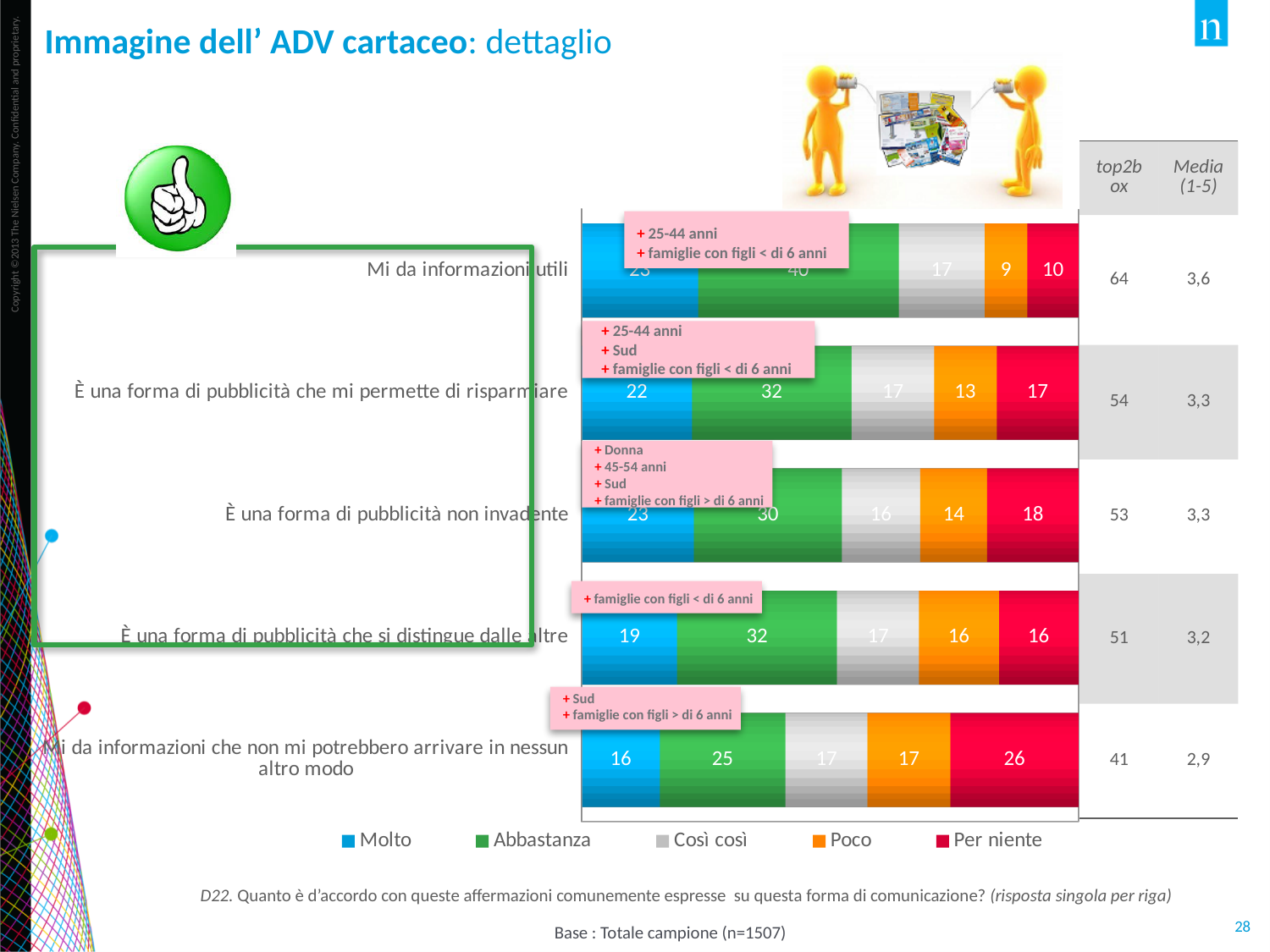
How many statements (categories) are plotted in the chart? 5 Which legend entry is shown in red? Per niente What is the difference between the 'Abbastanza' value for 'È una forma di pubblicità che si distingue dalle altre' and the 'Abbastanza' value for 'Mi da informazioni che non mi potrebbero arrivare in nessun altro modo'? 7 Which statement has the highest 'Per niente' value? Mi da informazioni che non mi potrebbero arrivare in nessun altro modo What is the 'Poco' value for 'È una forma di pubblicità che mi permette di risparmiare'? 13 What is the 'Molto' value for 'È una forma di pubblicità che si distingue dalle altre'? 19 What is the 'Così così' value for 'È una forma di pubblicità non invadente'? 16 How many series does the legend list? 5 Which is larger: the 'Per niente' value for 'È una forma di pubblicità non invadente' or the 'Per niente' value for 'È una forma di pubblicità che si distingue dalle altre'? È una forma di pubblicità non invadente What type of chart is shown on the slide? Stacked bar chart Which statement has the lowest 'Poco' value? Mi da informazioni utili What is the 'Per niente' value for 'Mi da informazioni che non mi potrebbero arrivare in nessun altro modo'? 26